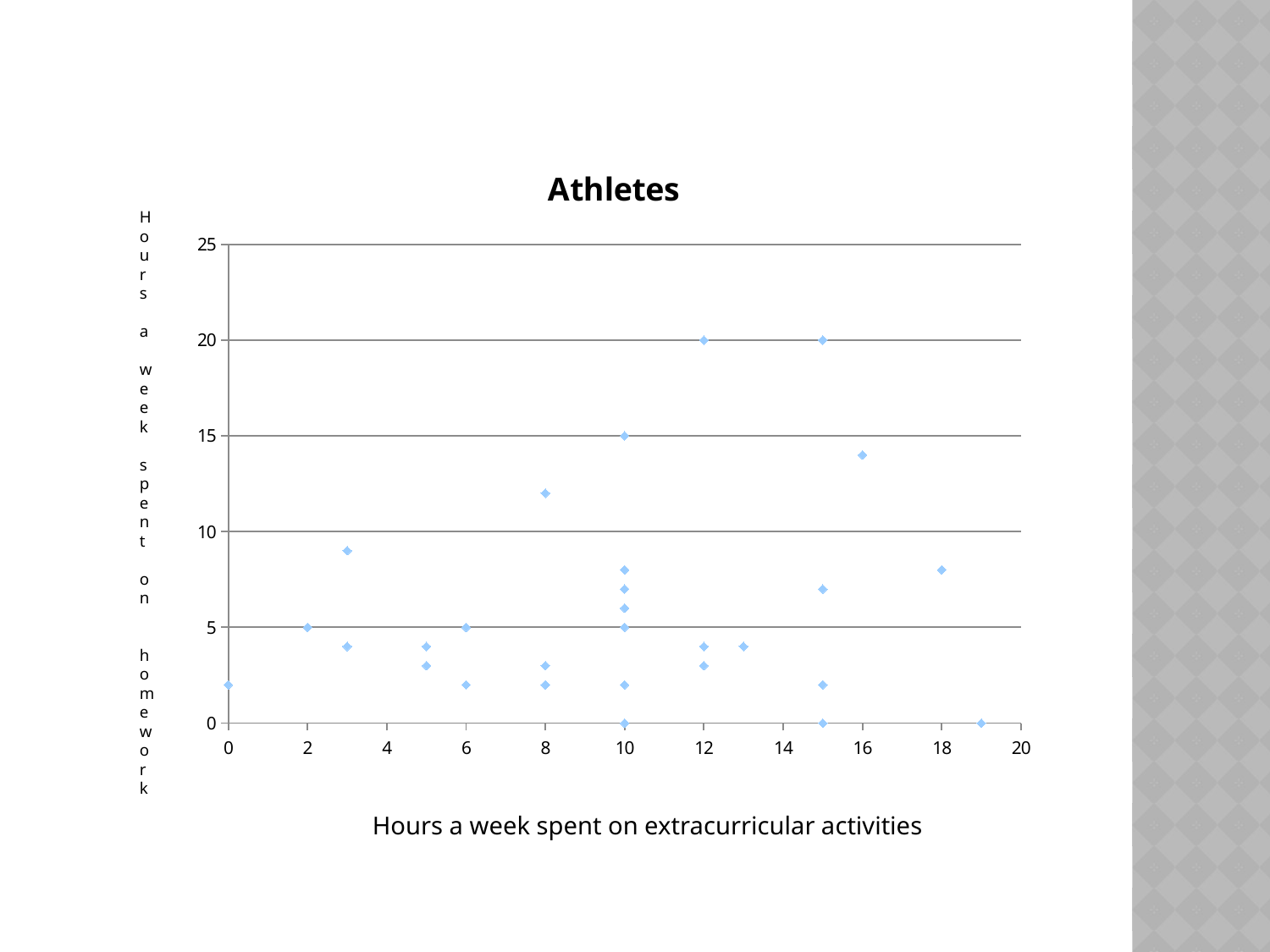
What is the title of the chart? Athletes How many points are plotted at 10 hours of extracurricular activities? 7 How many hours of homework does the point at 2 hours of extracurricular activities show? 5 Is the homework value for the point at 18 hours of extracurricular activities greater or less than 10? less What kind of chart is shown on the slide? scatter chart How many hours of homework does the point at 19 hours of extracurricular activities show? 0 Which point shows more homework hours: the one at 16 hours of extracurricular activities or the one at 18 hours? the one at 16 hours What is the highest homework value among the points at 10 hours of extracurricular activities? 15 Is the highest homework value at 8 hours of extracurricular activities greater or less than 10? greater Is the homework value for the point at 16 hours of extracurricular activities greater or less than 10? greater What is the label of the horizontal axis? Hours a week spent on extracurricular activities What is the highest number of hours spent on homework shown by any point on the chart? 20